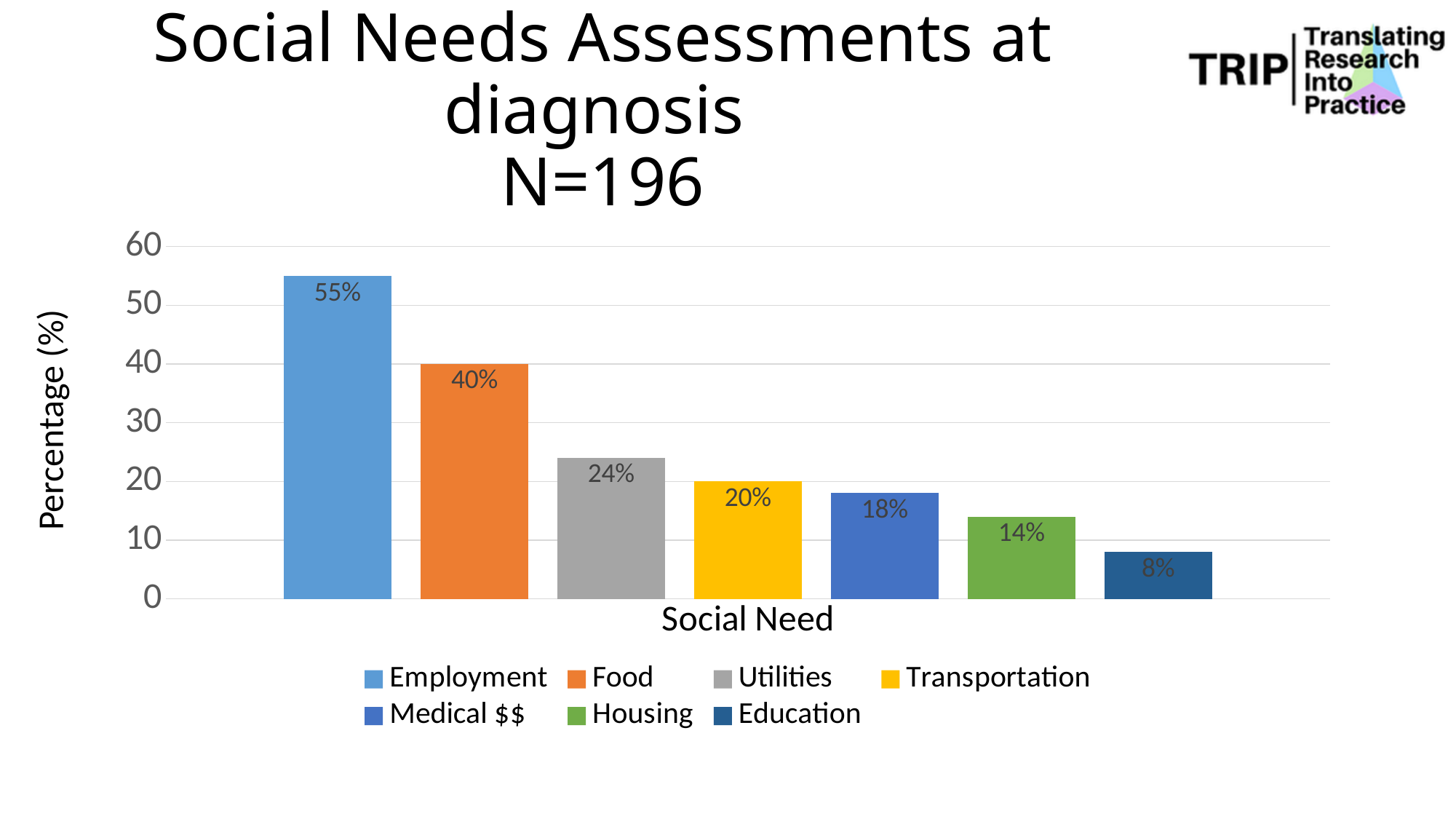
What is the difference in percentage points between Employment and Food? 15 What kind of chart is shown on the slide? Bar chart What percentage is shown for Employment? 55% What percentage is shown for Food? 40% What percentage is shown for Medical $$? 18% Which social need has the highest percentage? Employment What is the label of the vertical axis? Percentage (%) What is the difference in percentage points between Utilities and Housing? 10 What percentage is shown for Education? 8% Which social need has the lowest percentage? Education How many social need categories are plotted in the chart? 7 Which is larger, the value for Transportation or the value for Medical $$? Transportation